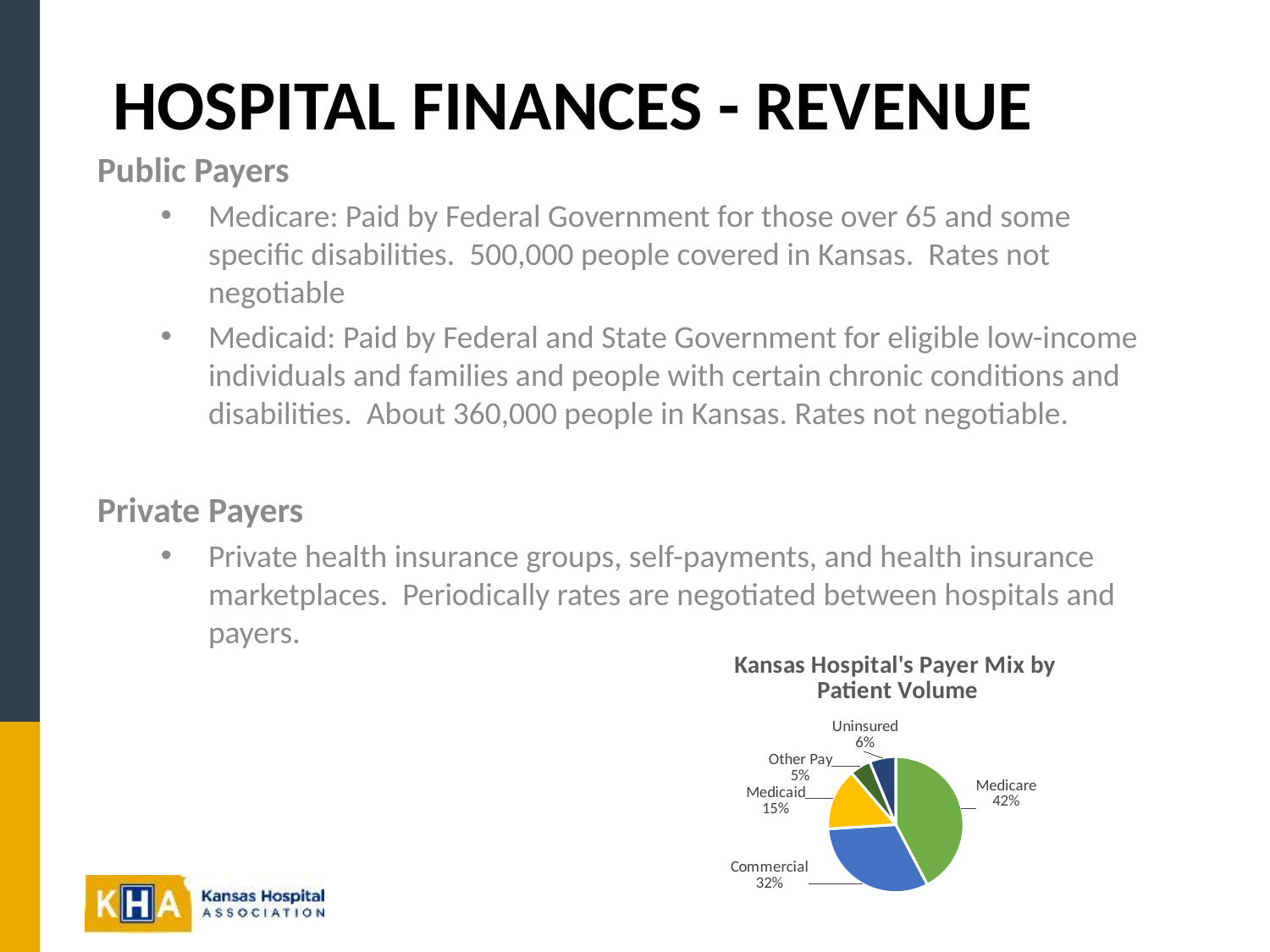
What is the difference in percentage points between the Medicare and Commercial shares in the pie chart? 10 What share of patient volume does Uninsured account for in the pie chart? 6% Which payer has the smallest share in the pie chart? Other Pay What type of chart is shown on the slide? pie chart How many payer categories are shown in the pie chart? 5 What share of patient volume does Commercial account for in the pie chart? 32% What share of patient volume does Medicare account for in the pie chart? 42% What share of patient volume does Other Pay account for in the pie chart? 5% Which is larger in the pie chart, the Medicaid share or the Uninsured share? Medicaid Which payer has the largest share in the pie chart? Medicare What share of patient volume does Medicaid account for in the pie chart? 15% What is the title of the pie chart on the slide? Kansas Hospital's Payer Mix by Patient Volume